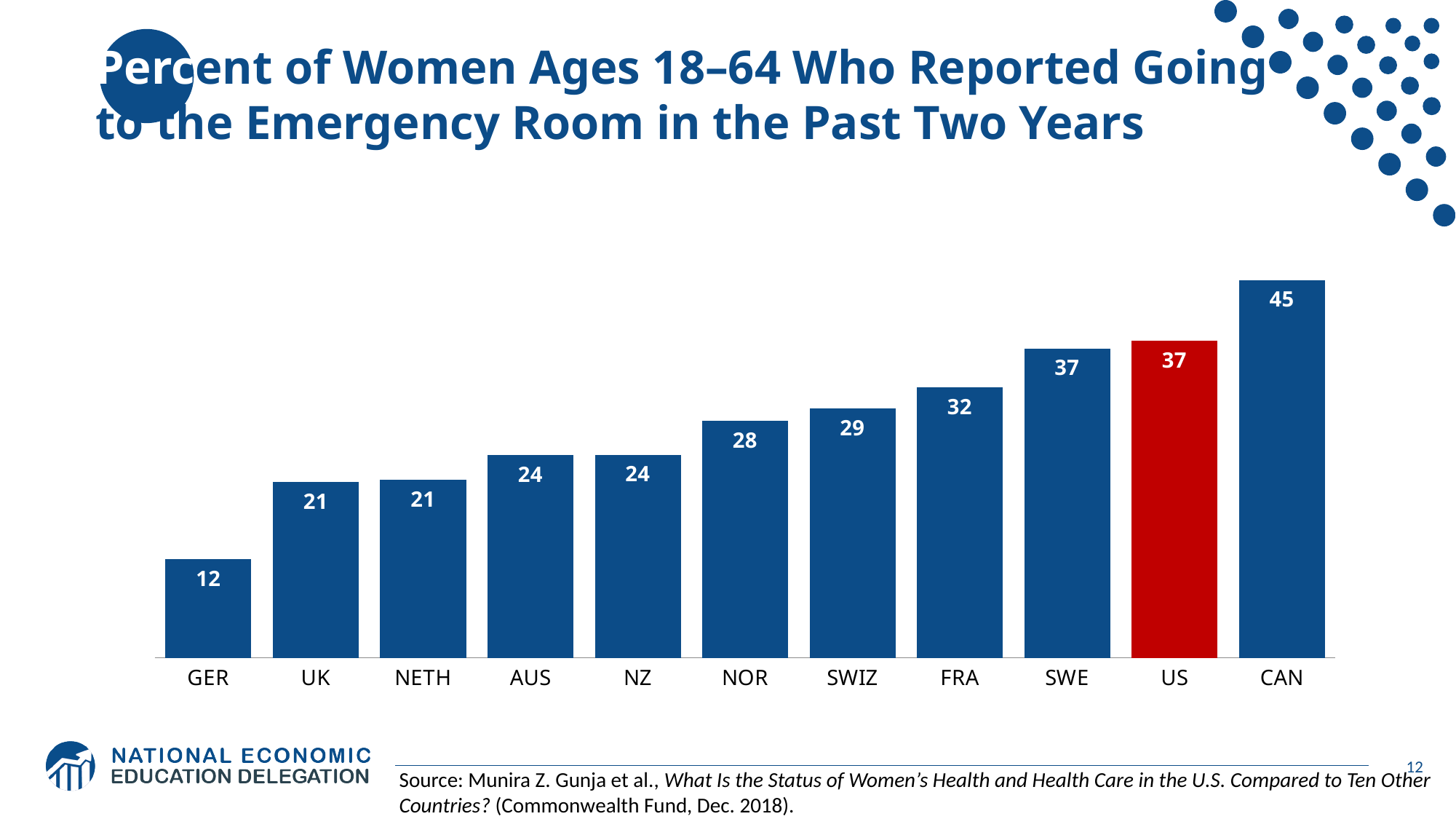
What is the difference between the values for FRA and GER? 20 Which is larger, the value for SWIZ or the value for AUS? SWIZ What kind of chart is shown on the slide? bar chart What is the value for NOR? 28 What is the value for GER? 12 What is the difference between the values for CAN and the US? 8 How many countries are shown on the chart? 11 Which country has the lowest value? GER Which country has the highest value? CAN Which bar is coloured red instead of blue? US Do the values rise or fall from left to right across the chart? rise What is the value for the US? 37